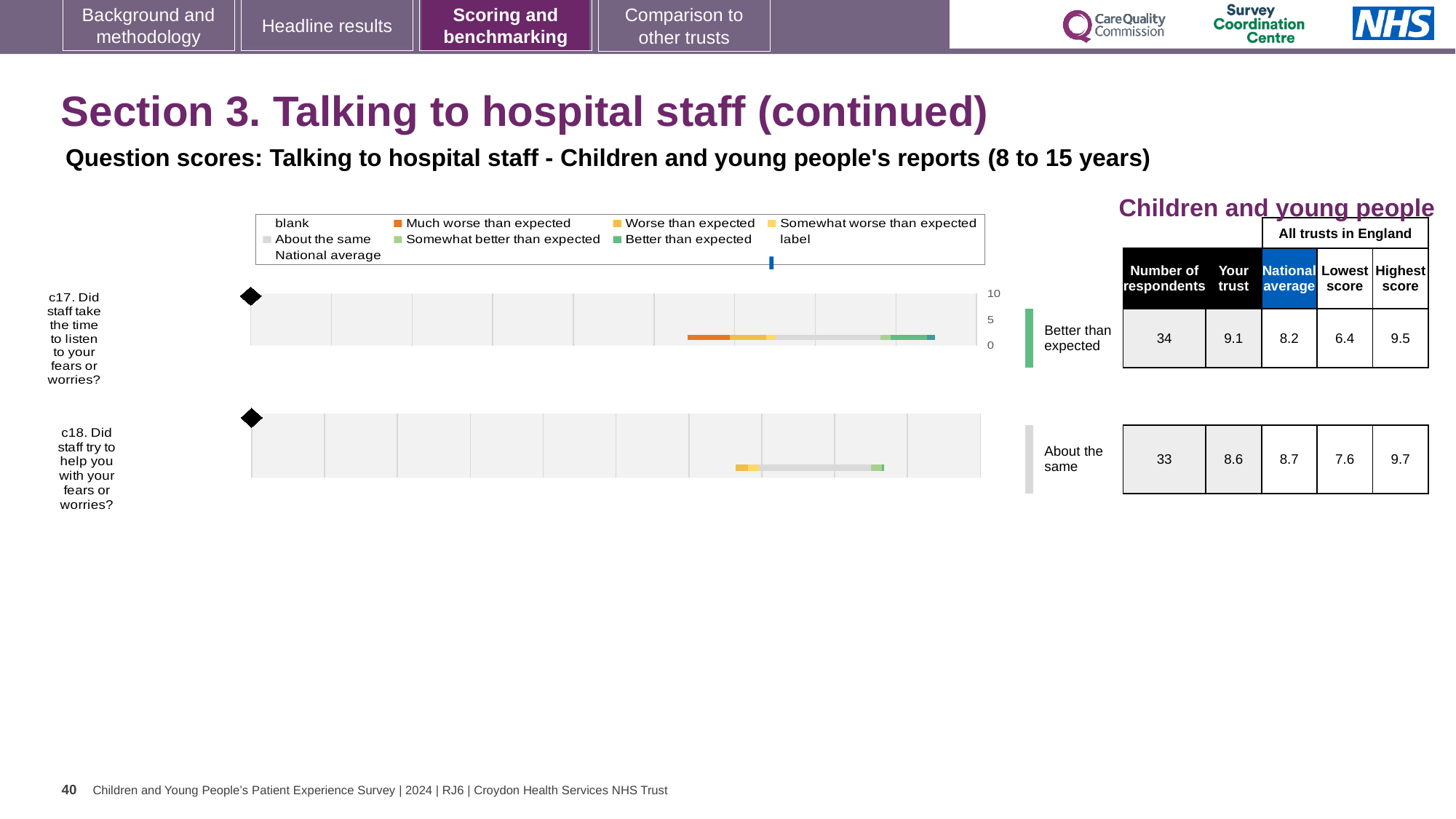
What is the lowest score across all trusts in England for c18? 7.6 For c17, what is the difference between the 'Your trust' score and the national average? 0.9 What is the highest score across all trusts in England for c18? 9.7 For c18 (Did staff try to help you with your fears or worries?), what is the national average score? 8.7 What benchmark category is shown for c17? Better than expected For c18, what is the difference between the highest score and the lowest score across all trusts in England? 2.1 How many respondents answered question c17? 34 For c17, which is higher: the 'Your trust' score or the national average? Your trust Which question has the higher 'Your trust' score, c17 or c18? c17 For c17 (Did staff take the time to listen to your fears or worries?), what is the 'Your trust' score? 9.1 What kind of chart is used to show the question scores on this slide? Bar chart How many survey questions are charted on this slide? 2